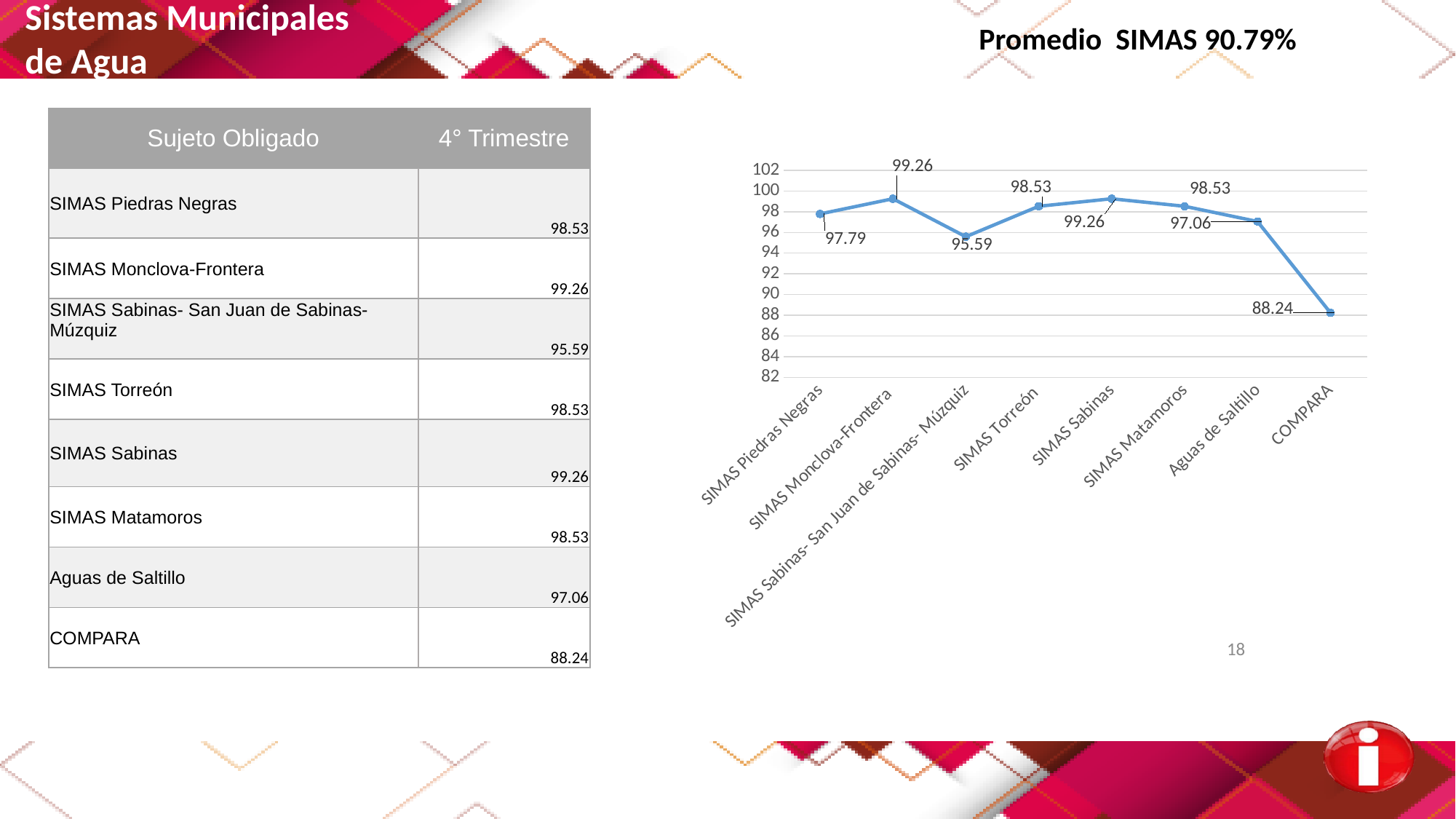
Which has a larger value, SIMAS Torreón or SIMAS Sabinas- San Juan de Sabinas- Múzquiz? SIMAS Torreón What is the difference between the values for Aguas de Saltillo and COMPARA? 8.82 Is the value for COMPARA greater or less than 90? less How many sujetos obligados are plotted on the chart? 8 What is the value for SIMAS Matamoros on the chart? 98.53 What is the difference between the values for SIMAS Monclova-Frontera and SIMAS Sabinas- San Juan de Sabinas- Múzquiz? 3.67 Which sujeto obligado has the lowest value on the chart? COMPARA What is the value for SIMAS Sabinas- San Juan de Sabinas- Múzquiz on the chart? 95.59 Does the line rise or fall from Aguas de Saltillo to COMPARA? fall What is the value for Aguas de Saltillo on the chart? 97.06 What is the value for COMPARA on the chart? 88.24 What kind of chart is shown on the slide? line chart